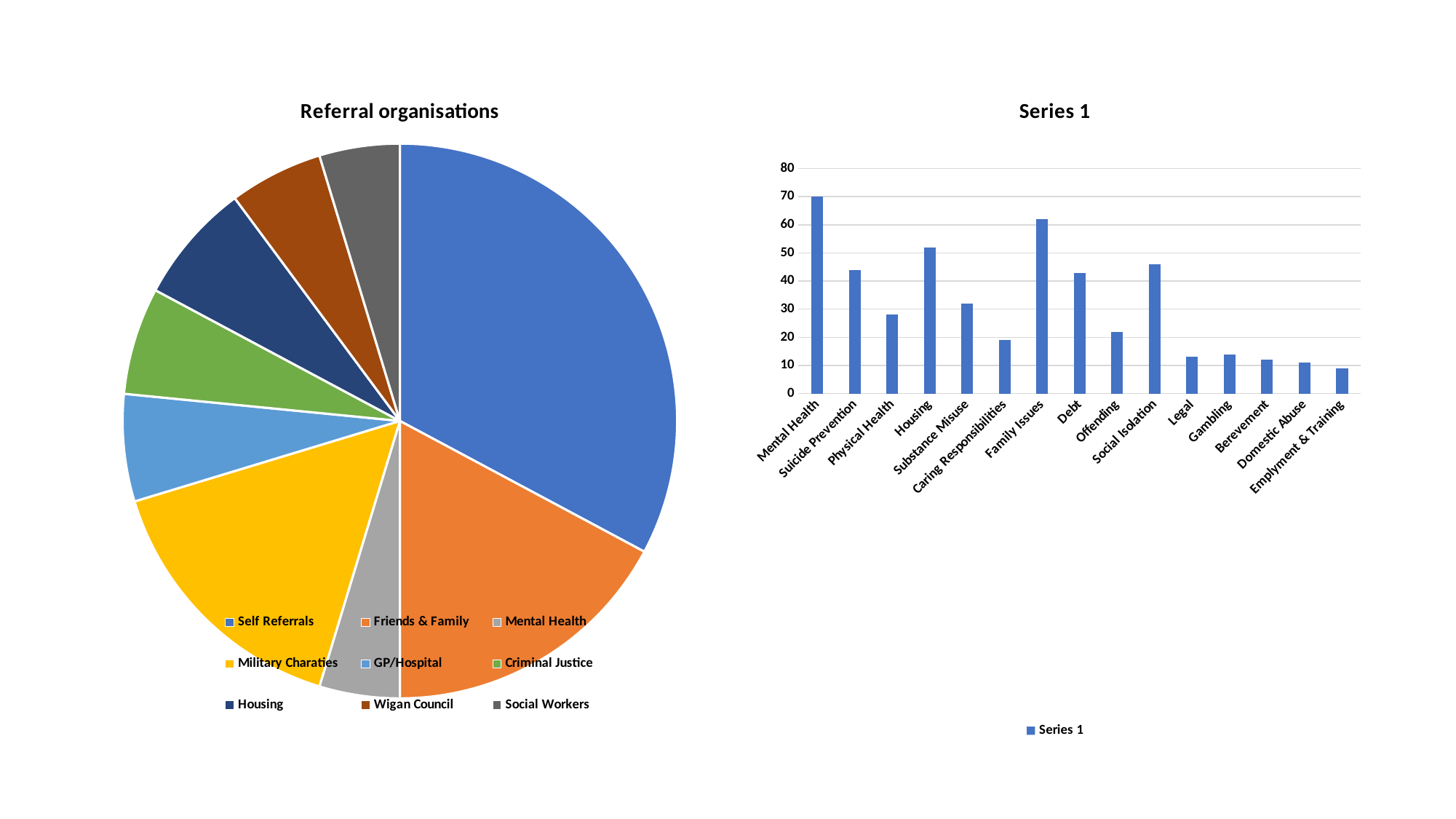
In the 'Referral organisations' pie chart, which category has the largest slice? Self Referrals In the 'Referral organisations' pie chart, which slice is larger: Friends & Family or GP/Hospital? Friends & Family What kind of chart is the 'Series 1' chart on the right? bar chart What kind of chart is the 'Referral organisations' chart on the left? pie chart In the 'Series 1' bar chart, is the value for Family Issues greater or less than 60? greater In the 'Series 1' bar chart, which is larger: Housing or Substance Misuse? Housing In the 'Series 1' bar chart, which category has the highest bar? Mental Health In the 'Referral organisations' pie chart, what colour is the Military Charaties slice? yellow How many categories are shown on the x axis of the 'Series 1' bar chart? 15 How many categories does the legend of the 'Referral organisations' pie chart list? 9 In the 'Series 1' bar chart, which category has the lowest bar? Emplyment & Training